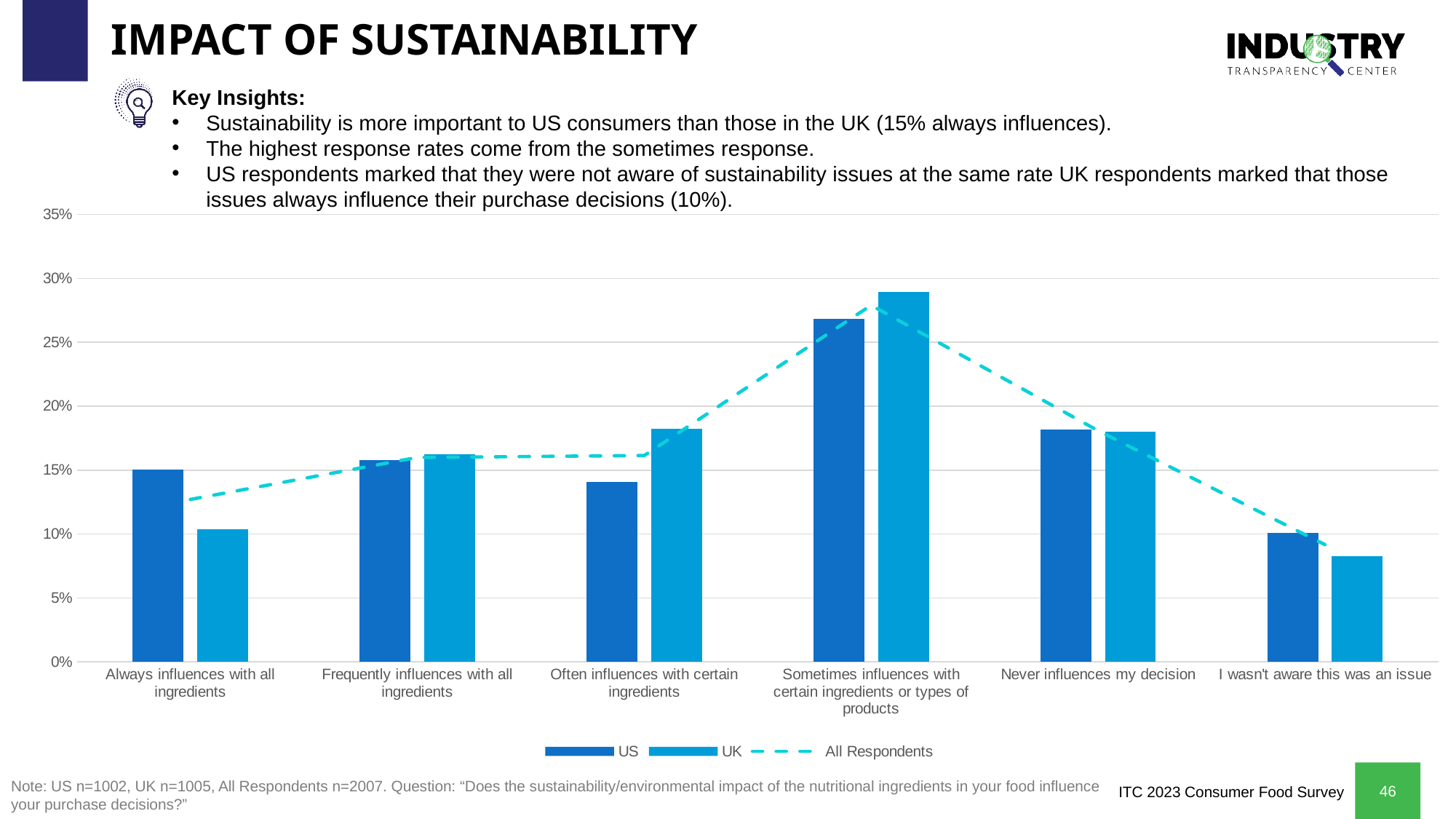
Is the UK value for 'Sometimes influences with certain ingredients or types of products' greater or less than 25%? greater Which category has the lowest US value? I wasn't aware this was an issue Which category has the lowest UK value? I wasn't aware this was an issue Which category has the highest UK value? Sometimes influences with certain ingredients or types of products Is the UK value for 'I wasn't aware this was an issue' greater or less than 10%? less What is the US value for 'Always influences with all ingredients'? 15% How many series does the legend list? 3 How many response categories are shown on the x axis? 6 For 'Always influences with all ingredients', which is larger, the US or the UK value? US What type of chart is shown on the slide? Bar chart with a dashed line series For 'Often influences with certain ingredients', which is larger, the US or the UK value? UK Does the All Respondents line rise or fall from 'Sometimes influences with certain ingredients or types of products' to 'I wasn't aware this was an issue'? fall